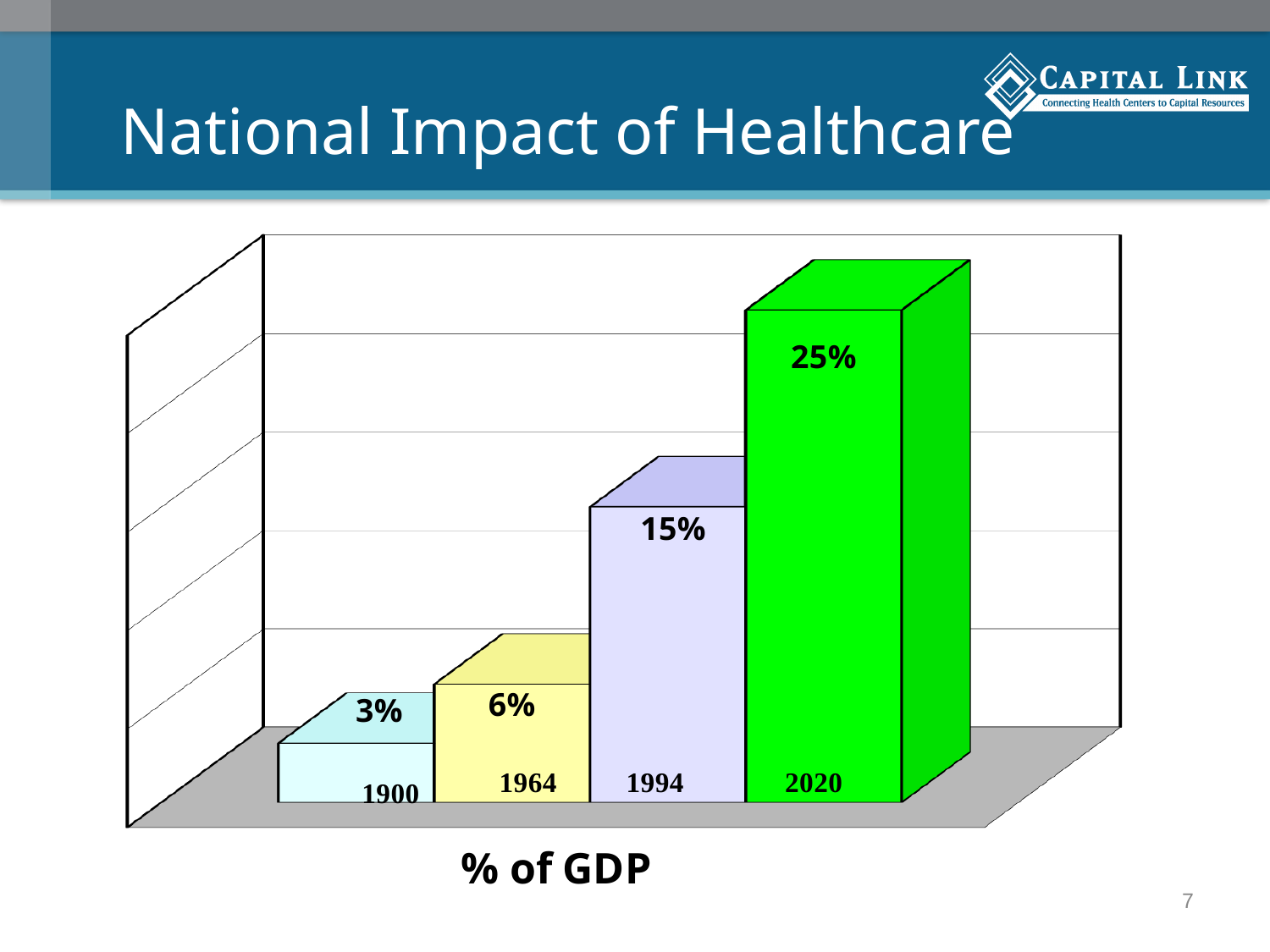
What is the value for 1994? 15% What is the difference between the values for 2020 and 1994? 10% What is the value for 2020? 25% What is the difference between the values for 1964 and 1900? 3% Which year has the lowest value? 1900 How many years are shown on the chart? 4 Which is larger, the value for 1994 or the value for 1964? 1994 What kind of chart is this? bar chart Do the values rise or fall from 1900 to 2020? rise What is the value for 1900? 3% What is the value for 1964? 6% Which year has the highest value? 2020